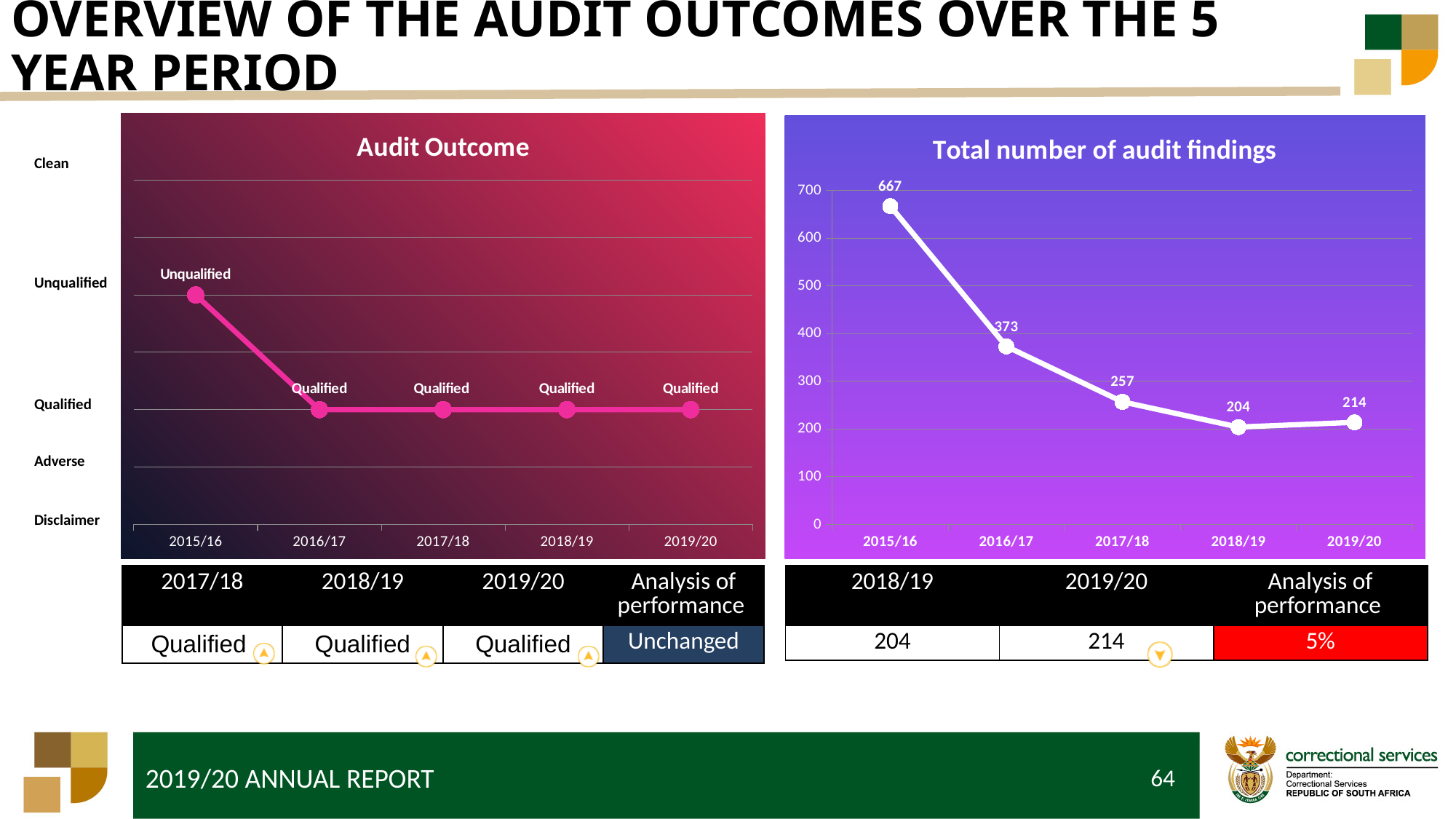
In the 'Total number of audit findings' chart, which year has the highest number of findings? 2015/16 In the 'Total number of audit findings' chart, what is the value for 2015/16? 667 In the 'Total number of audit findings' chart, what is the value for 2017/18? 257 In the 'Audit Outcome' chart, what is the audit outcome for 2015/16? Unqualified In the 'Total number of audit findings' chart, which is larger, the value for 2018/19 or 2019/20? 2019/20 In the 'Total number of audit findings' chart, which year has the lowest number of findings? 2018/19 What kind of chart is the 'Audit Outcome' chart? Line chart In the 'Total number of audit findings' chart, do the values generally rise or fall from 2015/16 to 2018/19? Fall In the 'Total number of audit findings' chart, what is the difference between the values for 2015/16 and 2016/17? 294 In the 'Total number of audit findings' chart, how many years are plotted on the x axis? 5 What kind of chart is the 'Total number of audit findings' chart? Line chart In the 'Audit Outcome' chart, what is the audit outcome for 2019/20? Qualified